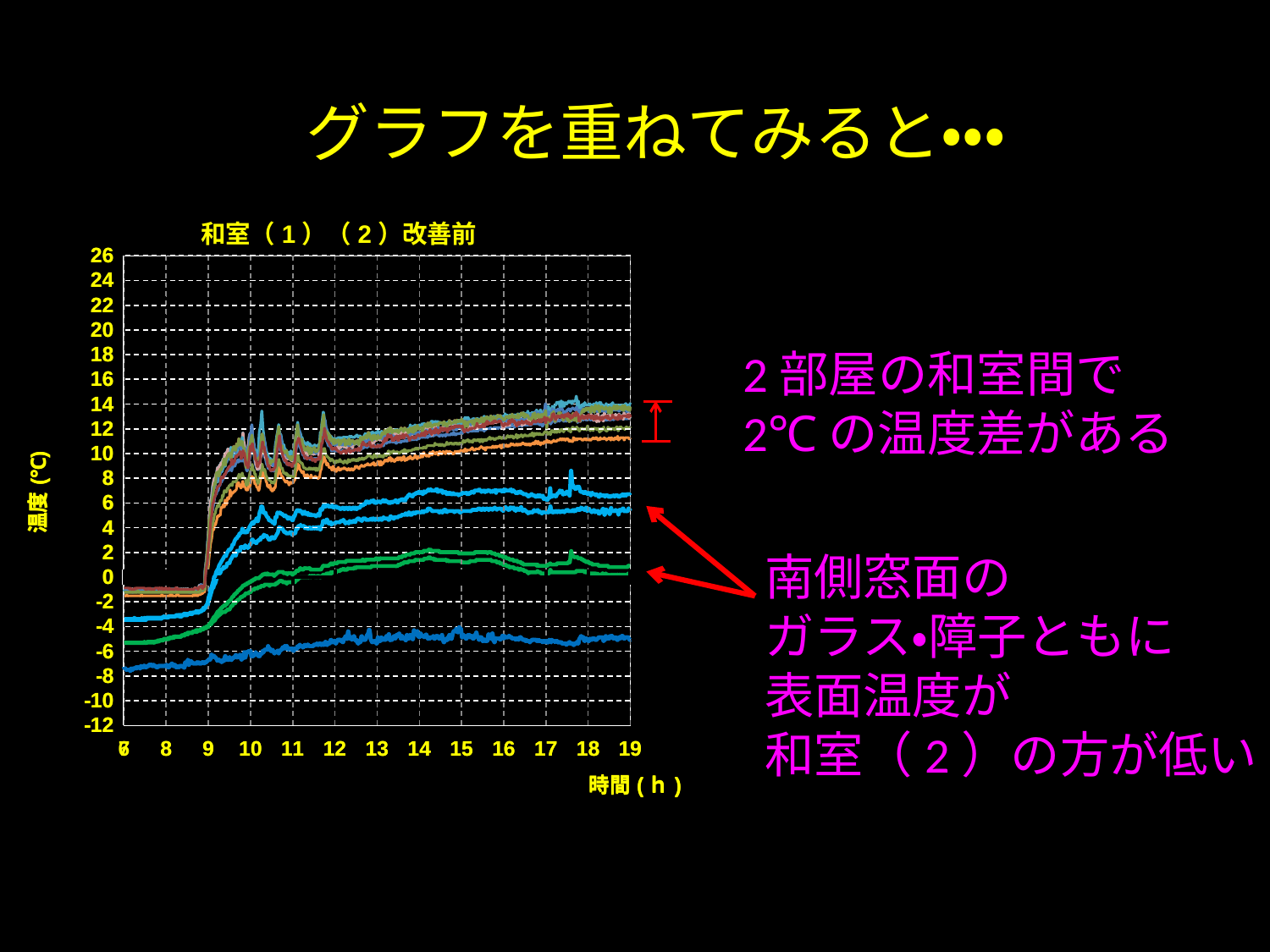
Are the values of the upper group of lines at hour 8 greater or less than 4? less What is the lowest value shown on the vertical axis of the chart? -12 Is the value of the highest line at hour 19 greater or less than 10? greater What is the highest value shown on the vertical axis of the chart? 26 Do the temperature lines in the chart generally rise or fall from hour 9 to hour 19? rise Is the value of the lowest line at hour 7 greater or less than 0? less What kind of chart is shown on the slide? line chart What is the label of the vertical axis of the chart? 温度 (℃) What is the last hour shown on the horizontal axis of the chart? 19 What is the title of the chart? 和室（1）（2）改善前